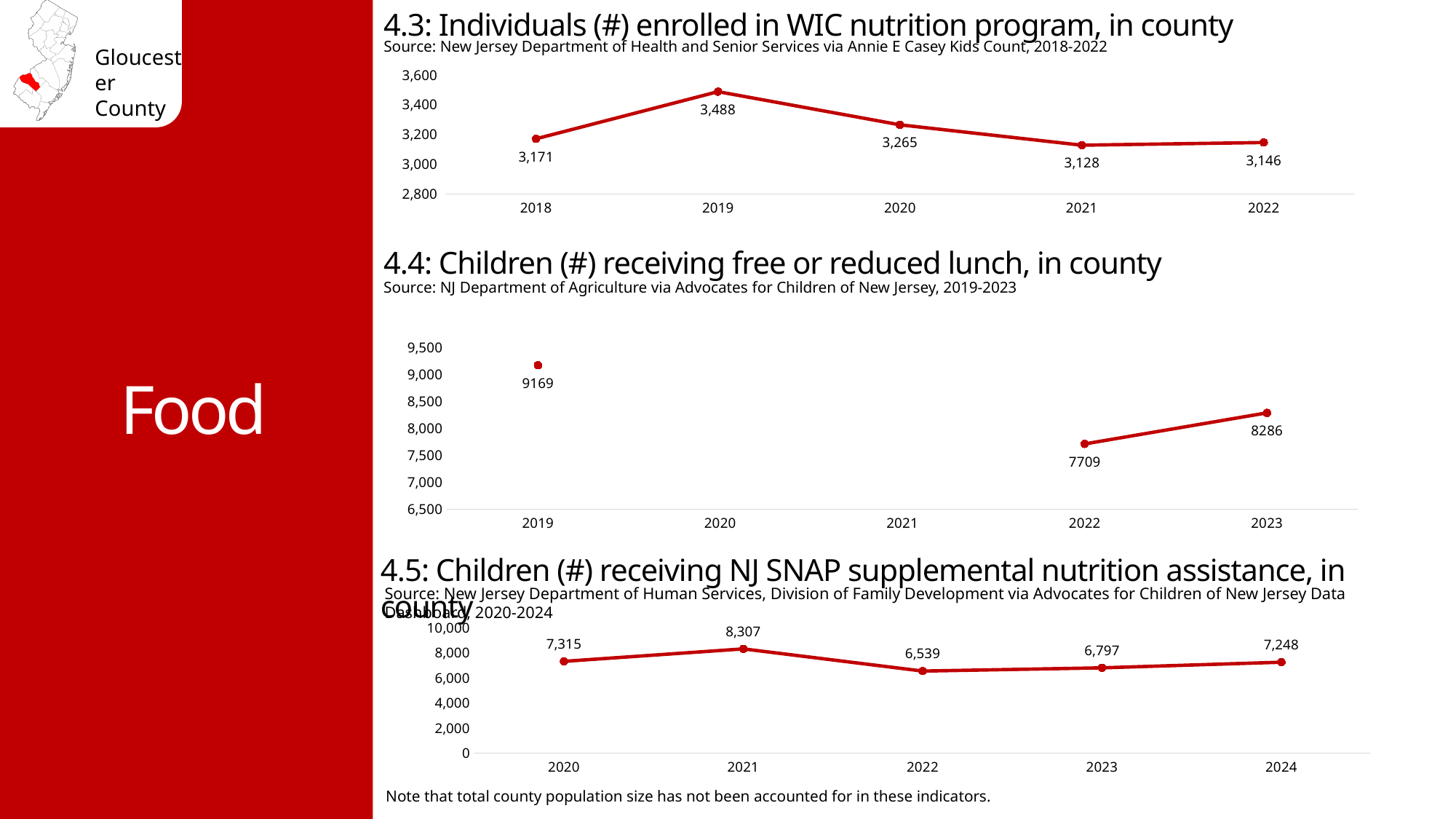
In the chart '4.3: Individuals (#) enrolled in WIC nutrition program, in county', how many years are plotted? 5 In the chart '4.4: Children (#) receiving free or reduced lunch, in county', what is the difference between the 2023 and 2022 values? 577 In the chart '4.4: Children (#) receiving free or reduced lunch, in county', what is the value for 2022? 7709 In the chart '4.3: Individuals (#) enrolled in WIC nutrition program, in county', what is the difference between the 2019 and 2018 values? 317 In the chart '4.3: Individuals (#) enrolled in WIC nutrition program, in county', which year has the lowest value? 2021 In the chart '4.5: Children (#) receiving NJ SNAP supplemental nutrition assistance, in county', what is the value for 2021? 8,307 In the chart '4.3: Individuals (#) enrolled in WIC nutrition program, in county', what is the value for 2019? 3,488 What type of chart is '4.5: Children (#) receiving NJ SNAP supplemental nutrition assistance, in county'? Line chart In the chart '4.5: Children (#) receiving NJ SNAP supplemental nutrition assistance, in county', which year has the lowest value? 2022 In the chart '4.4: Children (#) receiving free or reduced lunch, in county', which year has the highest value? 2019 In the chart '4.4: Children (#) receiving free or reduced lunch, in county', how many data points are plotted? 3 In the chart '4.5: Children (#) receiving NJ SNAP supplemental nutrition assistance, in county', is the value for 2020 larger or the value for 2024? 2020